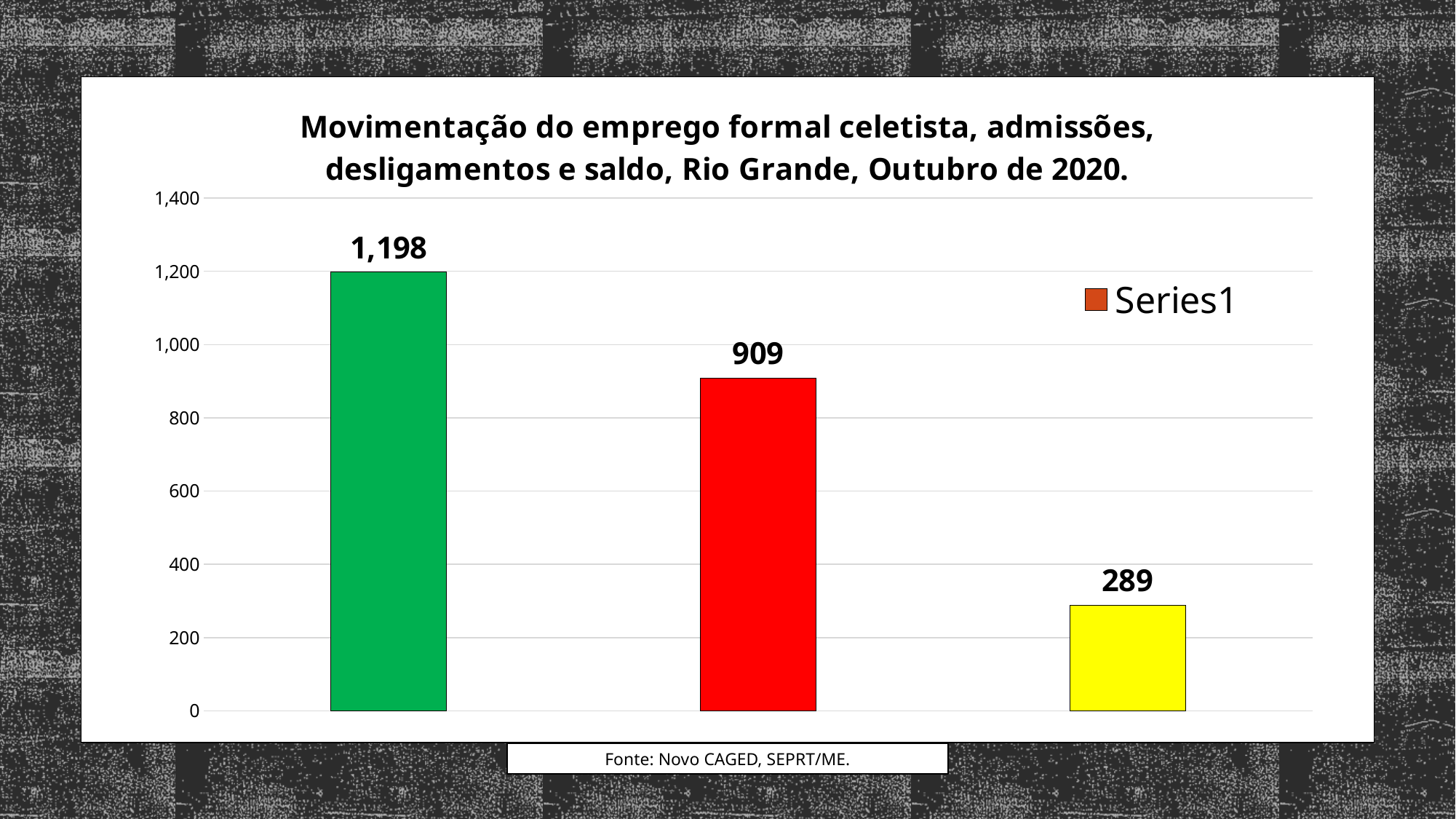
What is the difference between the value of the green bar and the value of the red bar? 289 What value is shown on the red bar (the middle bar)? 909 What kind of chart is shown on the slide? Bar chart Which is larger, the value of the red bar or the value of the yellow bar? The red bar (909) Which bar has the highest value? The green bar (first from the left), 1,198 Which bar has the lowest value? The yellow bar (rightmost), 289 What value is shown on the green bar (the first bar from the left)? 1,198 What is the difference between the value of the red bar and the value of the yellow bar? 620 What is the source cited below the chart? Fonte: Novo CAGED, SEPRT/ME. What value is shown on the yellow bar (the rightmost bar)? 289 How many bars are plotted in the chart? 3 Is the value of the red bar greater or less than 1,000? less